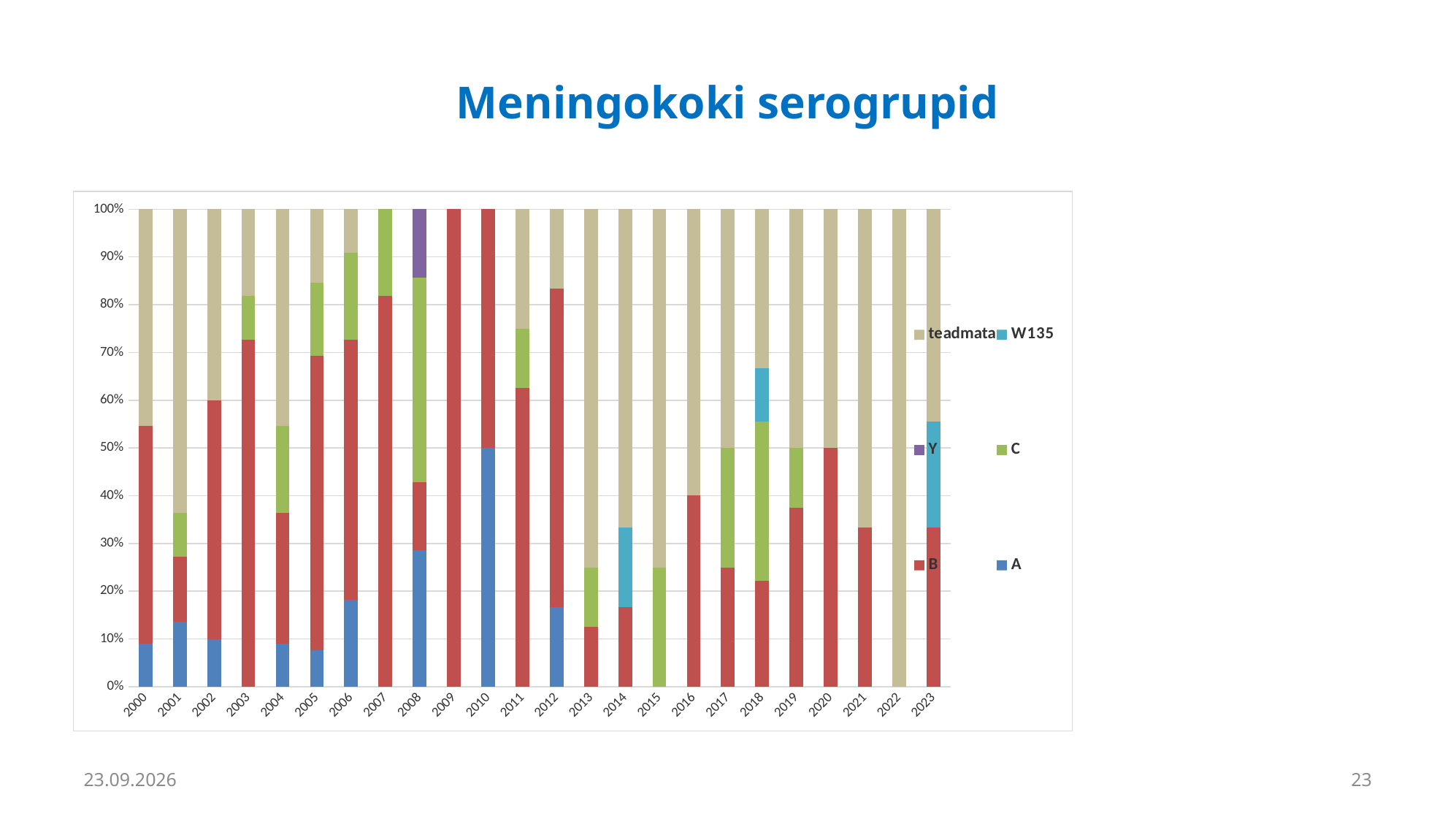
What is the total height of each stacked bar? 100% Is the B segment for 2013 greater or less than 20%? less Which series makes up the entire bar for 2022? teadmata Is the teadmata segment for 2015 greater or less than 70%? greater How many years are shown on the x axis? 24 What kind of chart is shown on the slide? Stacked bar chart What is the title of the chart? Meningokoki serogrupid Which years are covered on the x axis, from first to last? 2000 to 2023 Is the B segment for 2003 greater or less than 70%? greater How many series does the legend list? 6